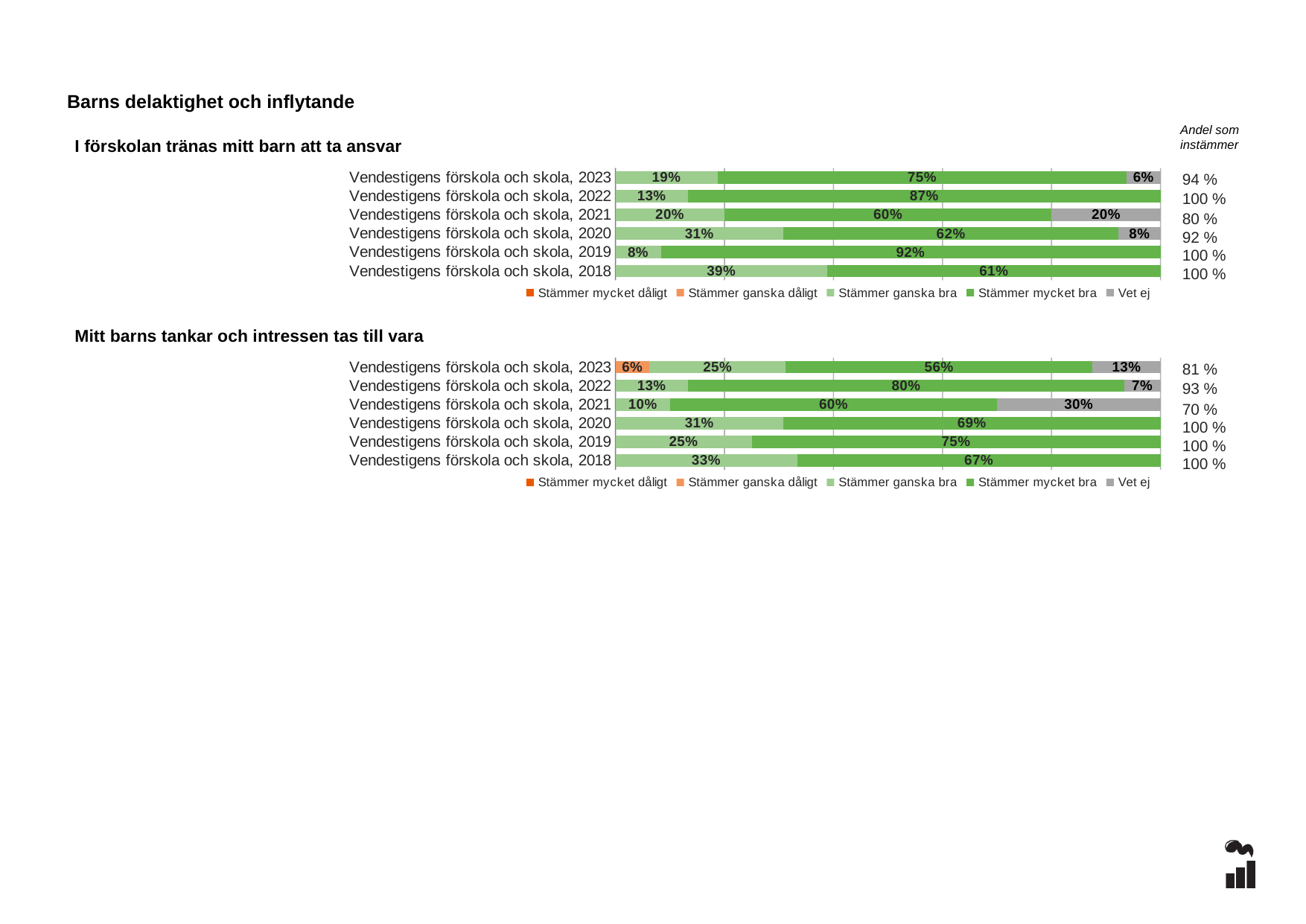
In the chart 'I förskolan tränas mitt barn att ta ansvar', which year has the lowest 'Stämmer ganska bra' value? Vendestigens förskola och skola, 2019 In the chart 'Mitt barns tankar och intressen tas till vara', which is larger: the 'Stämmer mycket bra' value for 2022 or for 2023? 2022 In the chart 'I förskolan tränas mitt barn att ta ansvar', which year has the highest 'Stämmer mycket bra' value? Vendestigens förskola och skola, 2019 How many series does the legend of the chart 'Mitt barns tankar och intressen tas till vara' list? 5 In the chart 'Mitt barns tankar och intressen tas till vara', what is the 'Andel som instämmer' for Vendestigens förskola och skola, 2021? 70 % In the chart 'Mitt barns tankar och intressen tas till vara', what is the 'Stämmer ganska dåligt' value for Vendestigens förskola och skola, 2023? 6% In the chart 'I förskolan tränas mitt barn att ta ansvar', what is the difference between the 'Stämmer mycket bra' values for 2019 and 2018? 31% In the chart 'I förskolan tränas mitt barn att ta ansvar', how many bars (years) are shown? 6 In the chart 'I förskolan tränas mitt barn att ta ansvar', what is the 'Stämmer mycket bra' value for Vendestigens förskola och skola, 2022? 87% What type of chart is 'I förskolan tränas mitt barn att ta ansvar'? Stacked bar chart In the chart 'Mitt barns tankar och intressen tas till vara', what is the 'Vet ej' value for Vendestigens förskola och skola, 2021? 30% In the chart 'I förskolan tränas mitt barn att ta ansvar', what is the 'Vet ej' value for Vendestigens förskola och skola, 2021? 20%